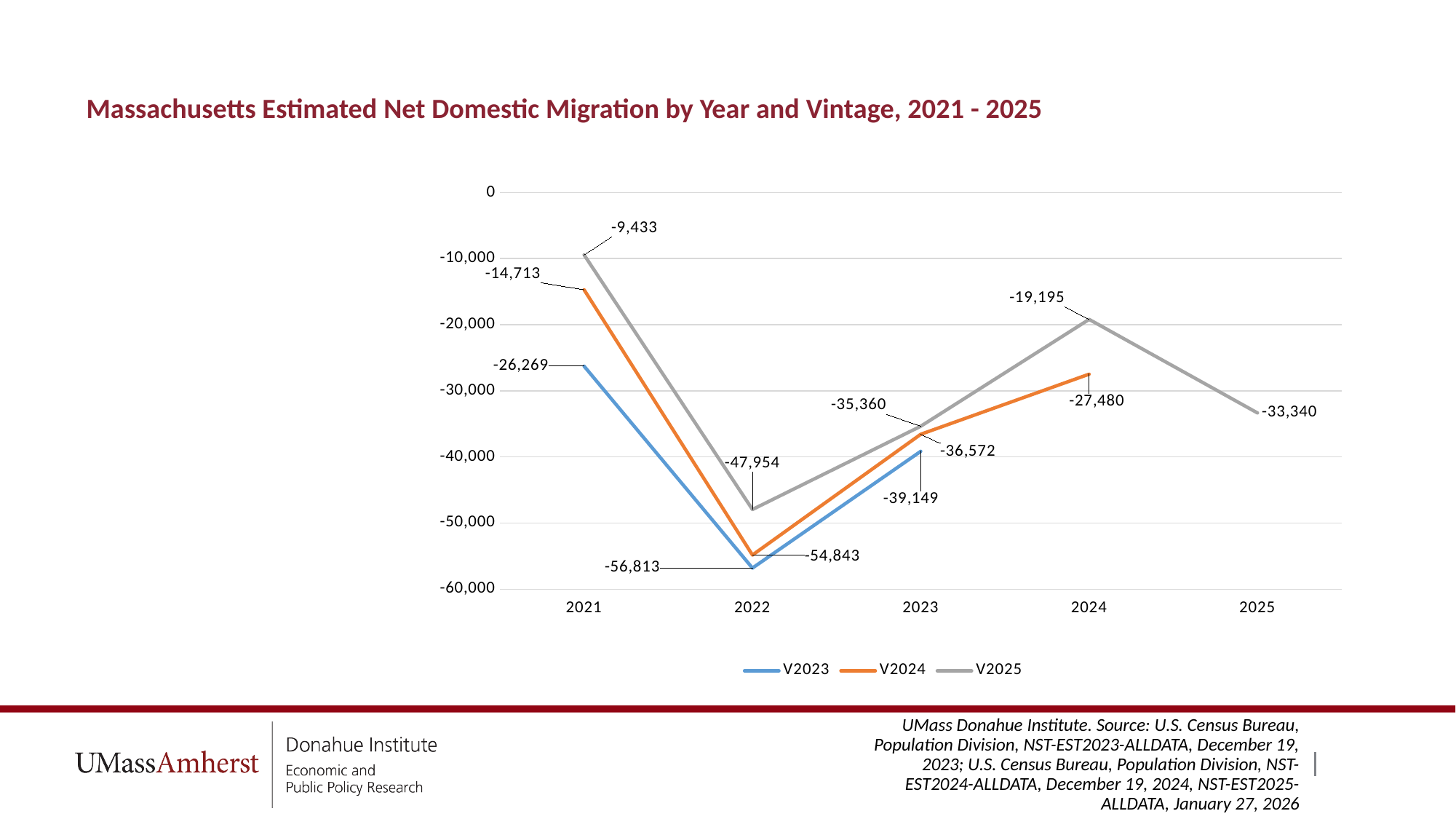
What is the V2025 value for 2025? -33,340 What is the V2025 value for 2022? -47,954 What is the V2024 value for 2024? -27,480 In which year does the V2023 series reach its lowest value? 2022 In which year does the V2025 series reach its highest value? 2021 What kind of chart is shown on the slide? Line chart How many years are shown on the x axis? 5 What is the difference between the V2024 and V2023 values for 2022? 1,970 How many series does the legend list? 3 What is the V2023 value for 2021? -26,269 Does the V2025 series rise or fall from 2024 to 2025? Fall Which series has the higher value for 2023, V2024 or V2025? V2025